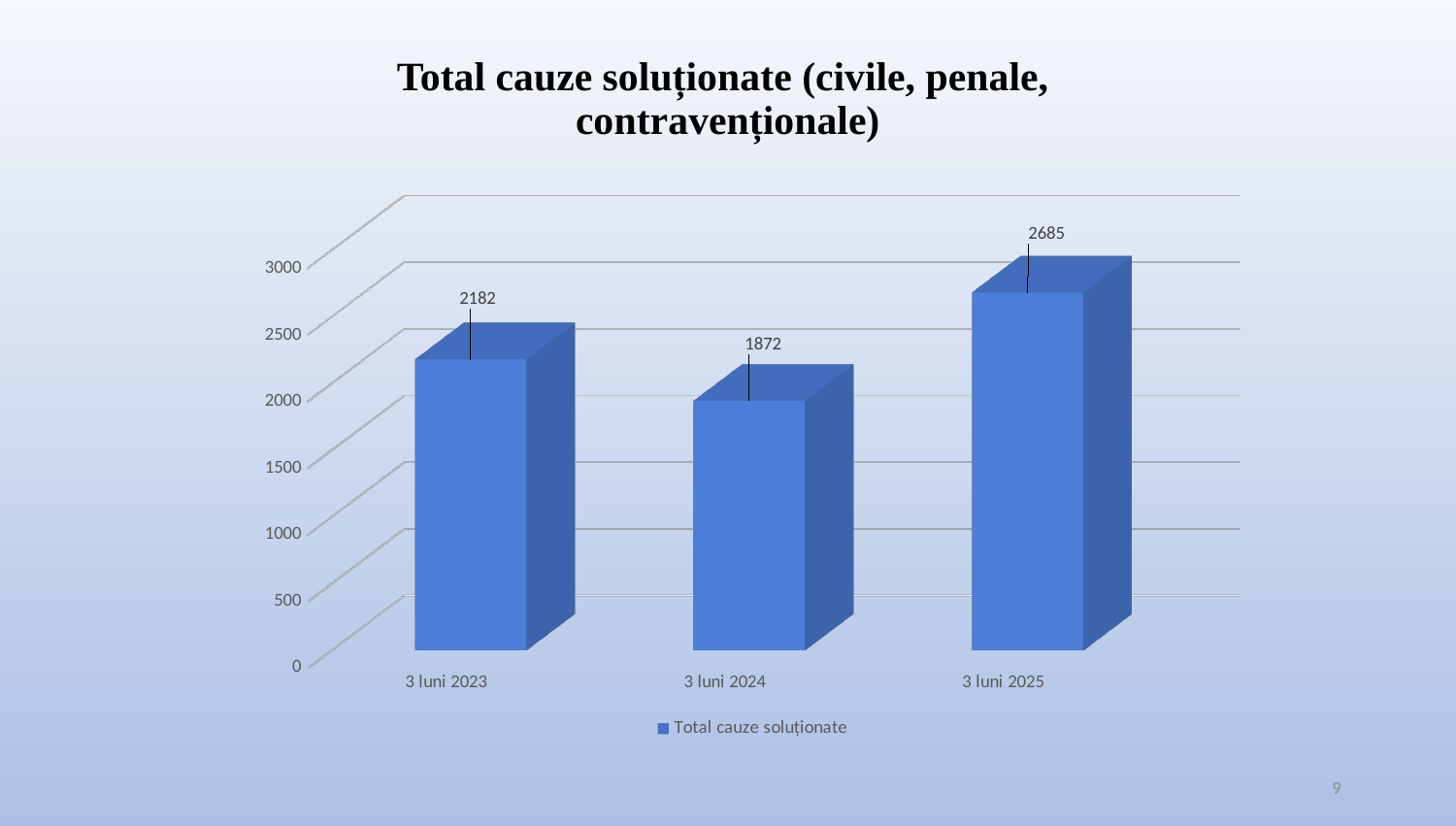
Is the value for 3 luni 2024 greater or less than 2000? less What is the difference between the values for 3 luni 2025 and 3 luni 2024? 813 What is the value for 3 luni 2024? 1872 What is the value for 3 luni 2025? 2685 Which category has the lowest value? 3 luni 2024 Which is larger, the value for 3 luni 2023 or the value for 3 luni 2025? 3 luni 2025 Which category has the highest value? 3 luni 2025 What kind of chart is shown on the slide? bar chart How many categories are shown on the x axis? 3 What series name does the legend list? Total cauze soluționate What is the difference between the values for 3 luni 2023 and 3 luni 2024? 310 What is the value for 3 luni 2023? 2182